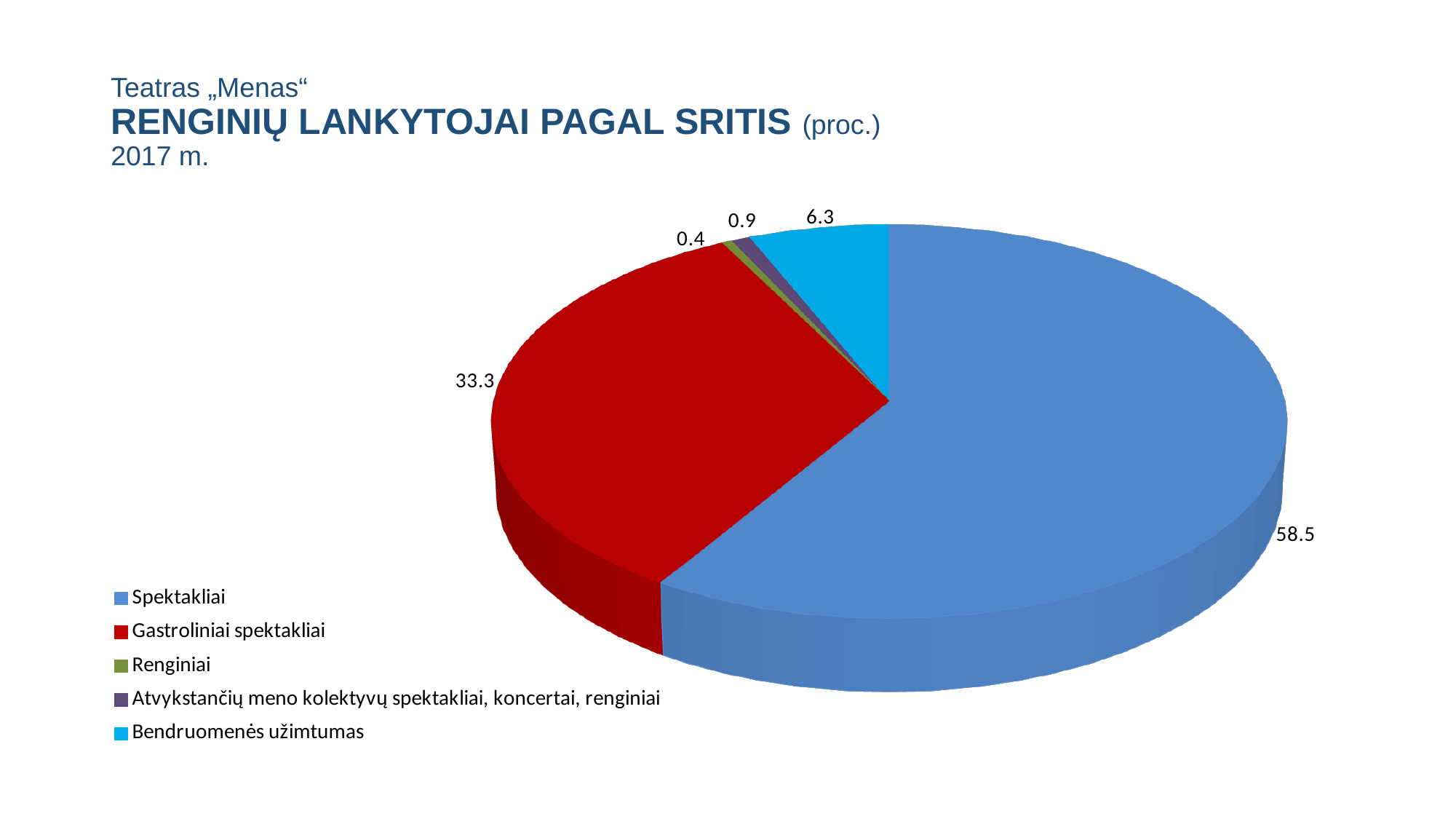
What value is shown for the slice labelled Atvykstančių meno kolektyvų spektakliai, koncertai, renginiai? 0.9 What is the difference between the values for Spektakliai and Gastroliniai spektakliai? 25.2 Which category has the largest slice of the pie? Spektakliai What value is shown for the Bendruomenės užimtumas slice? 6.3 Which is larger, the value for Bendruomenės užimtumas or the value for Atvykstančių meno kolektyvų spektakliai, koncertai, renginiai? Bendruomenės užimtumas Which category has the smallest slice of the pie? Renginiai What kind of chart is shown on the slide? Pie chart How many categories does the pie chart show? 5 What value is shown for the Spektakliai slice? 58.5 What value is shown for the Gastroliniai spektakliai slice? 33.3 What colour is the Gastroliniai spektakliai slice? Red What value is shown for the Renginiai slice? 0.4